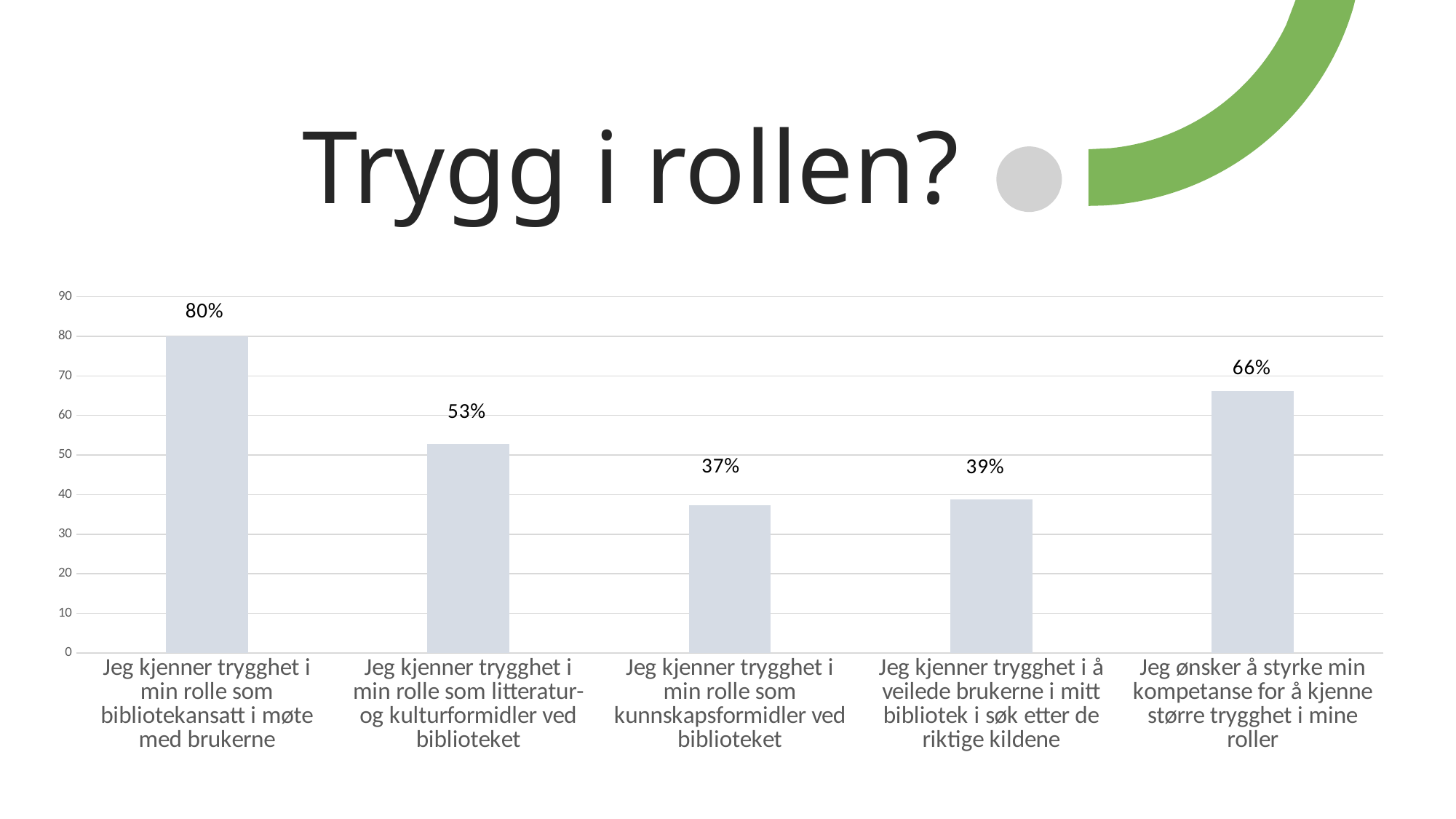
What is the value for "Jeg kjenner trygghet i min rolle som bibliotekansatt i møte med brukerne"? 80% What is the value for "Jeg ønsker å styrke min kompetanse for å kjenne større trygghet i mine roller"? 66% What is the title of the slide? Trygg i rollen? Which is larger: the value for "Jeg kjenner trygghet i min rolle som litteratur- og kulturformidler ved biblioteket" or the value for "Jeg kjenner trygghet i å veilede brukerne i mitt bibliotek i søk etter de riktige kildene"? Jeg kjenner trygghet i min rolle som litteratur- og kulturformidler ved biblioteket Is the value for "Jeg kjenner trygghet i å veilede brukerne i mitt bibliotek i søk etter de riktige kildene" greater or less than 40? less What is the value for "Jeg kjenner trygghet i min rolle som kunnskapsformidler ved biblioteket"? 37% How many categories are shown in the chart? 5 Which category has the lowest value? Jeg kjenner trygghet i min rolle som kunnskapsformidler ved biblioteket Which category has the highest value? Jeg kjenner trygghet i min rolle som bibliotekansatt i møte med brukerne What is the value for "Jeg kjenner trygghet i min rolle som litteratur- og kulturformidler ved biblioteket"? 53% What is the difference between the value for "Jeg kjenner trygghet i min rolle som bibliotekansatt i møte med brukerne" and the value for "Jeg ønsker å styrke min kompetanse for å kjenne større trygghet i mine roller"? 14% What kind of chart is shown on the slide? bar chart